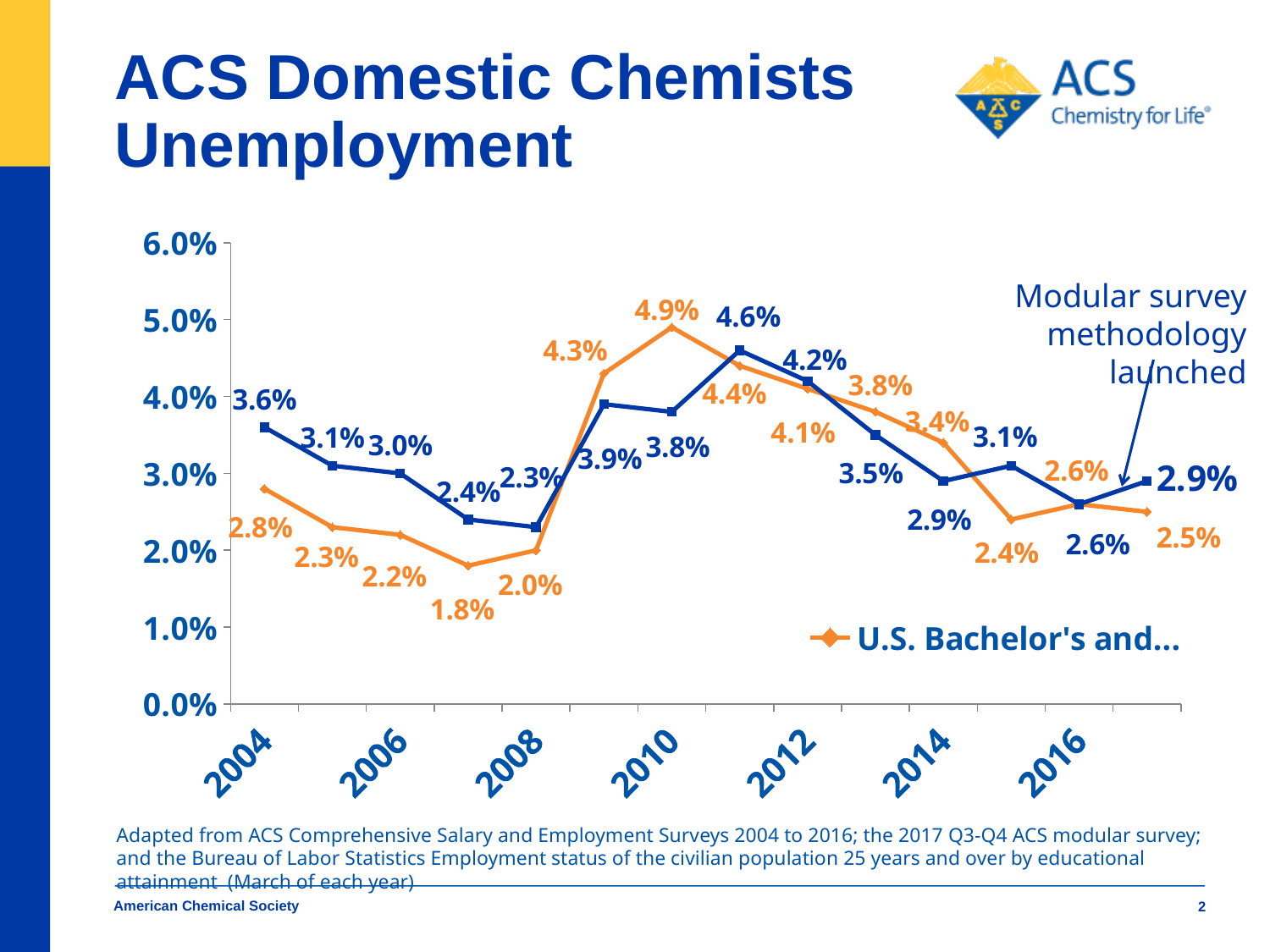
In 2010, which line has the higher value, the dark blue line or the orange line? the orange line How many data points does each line have? 14 What is the lowest value reached by the dark blue line? 2.3% What kind of chart is shown on the slide? line chart Is the value of the dark blue line in 2012 greater or less than 4.0%? greater What is the value of the orange 'U.S. Bachelor's and...' line in 2010? 4.9% What does the annotation with the arrow pointing to the end of the dark blue line say? Modular survey methodology launched What is the value of the orange line in 2014? 3.4% What is the lowest value reached by the orange line? 1.8% What is the highest value reached by the dark blue line? 4.6% In 2004, what is the difference between the dark blue line (3.6%) and the orange line (2.8%)? 0.8% What is the value of the dark blue line in 2004? 3.6%